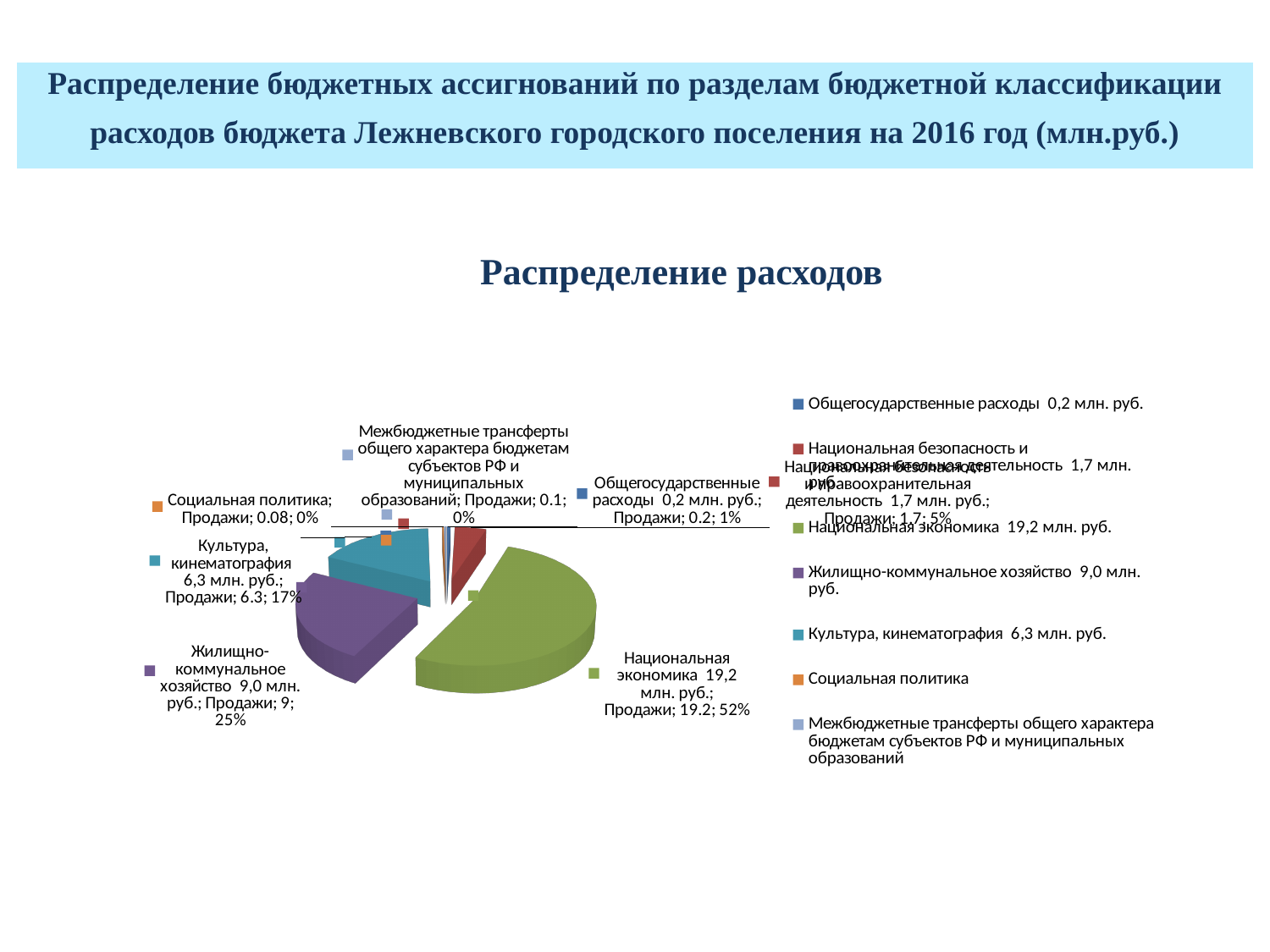
How many categories (slices) does the pie chart have? 7 What value is shown for Национальная экономика? 19.2 What share of the pie does Культура, кинематография take? 17% What kind of chart is shown on the slide? Pie chart What is the difference between the values for Национальная экономика and Жилищно-коммунальное хозяйство? 10.2 Which category has the largest slice? Национальная экономика What is the title of the chart? Распределение расходов What value is shown for Жилищно-коммунальное хозяйство? 9 Which is larger, the value for Культура, кинематография or for Национальная безопасность и правоохранительная деятельность? Культура, кинематография How many entries does the legend list? 7 What share of the pie does Национальная экономика take? 52% Which category has the smallest value? Социальная политика